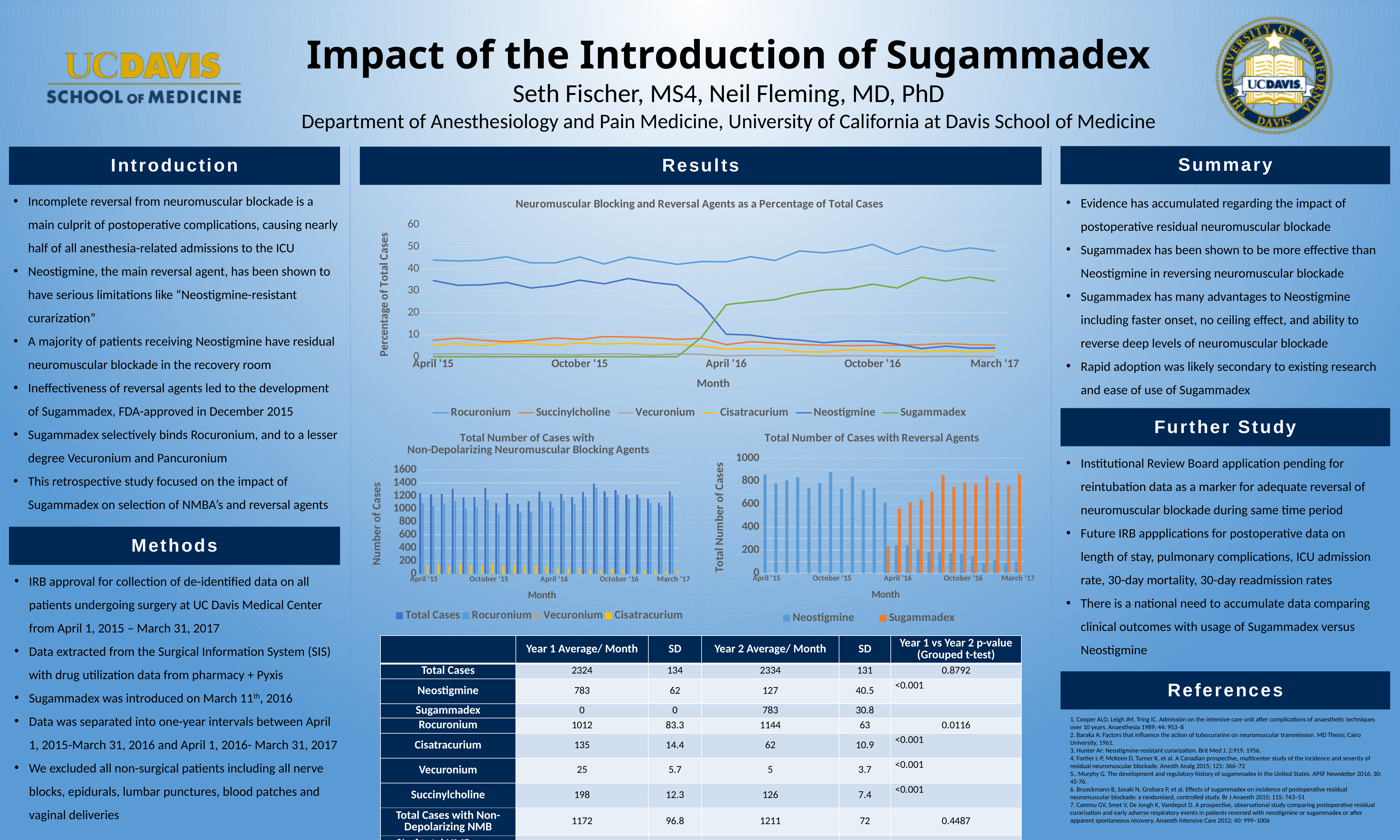
What kind of chart is 'Neuromuscular Blocking and Reversal Agents as a Percentage of Total Cases'? line chart In the 'Neuromuscular Blocking and Reversal Agents as a Percentage of Total Cases' chart, does the Sugammadex line rise or fall between April '16 and March '17? rise In the 'Total Number of Cases with Reversal Agents' chart, is the value for Neostigmine at April '15 greater or less than 600? greater What kind of chart is 'Total Number of Cases with Non-Depolarizing Neuromuscular Blocking Agents'? bar chart How many series does the legend of the 'Total Number of Cases with Reversal Agents' chart list? 2 In the 'Neuromuscular Blocking and Reversal Agents as a Percentage of Total Cases' chart, which series has the highest value at April '15? Rocuronium In the 'Neuromuscular Blocking and Reversal Agents as a Percentage of Total Cases' chart, is the value for Neostigmine at April '15 greater or less than 30? greater What is the y-axis label of the 'Neuromuscular Blocking and Reversal Agents as a Percentage of Total Cases' chart? Percentage of Total Cases How many series does the legend of the 'Neuromuscular Blocking and Reversal Agents as a Percentage of Total Cases' chart list? 6 In the 'Neuromuscular Blocking and Reversal Agents as a Percentage of Total Cases' chart, is the value for Rocuronium at March '17 greater or less than 40? greater In the 'Neuromuscular Blocking and Reversal Agents as a Percentage of Total Cases' chart, which is larger at March '17, Sugammadex or Neostigmine? Sugammadex How many series does the legend of the 'Total Number of Cases with Non-Depolarizing Neuromuscular Blocking Agents' chart list? 4